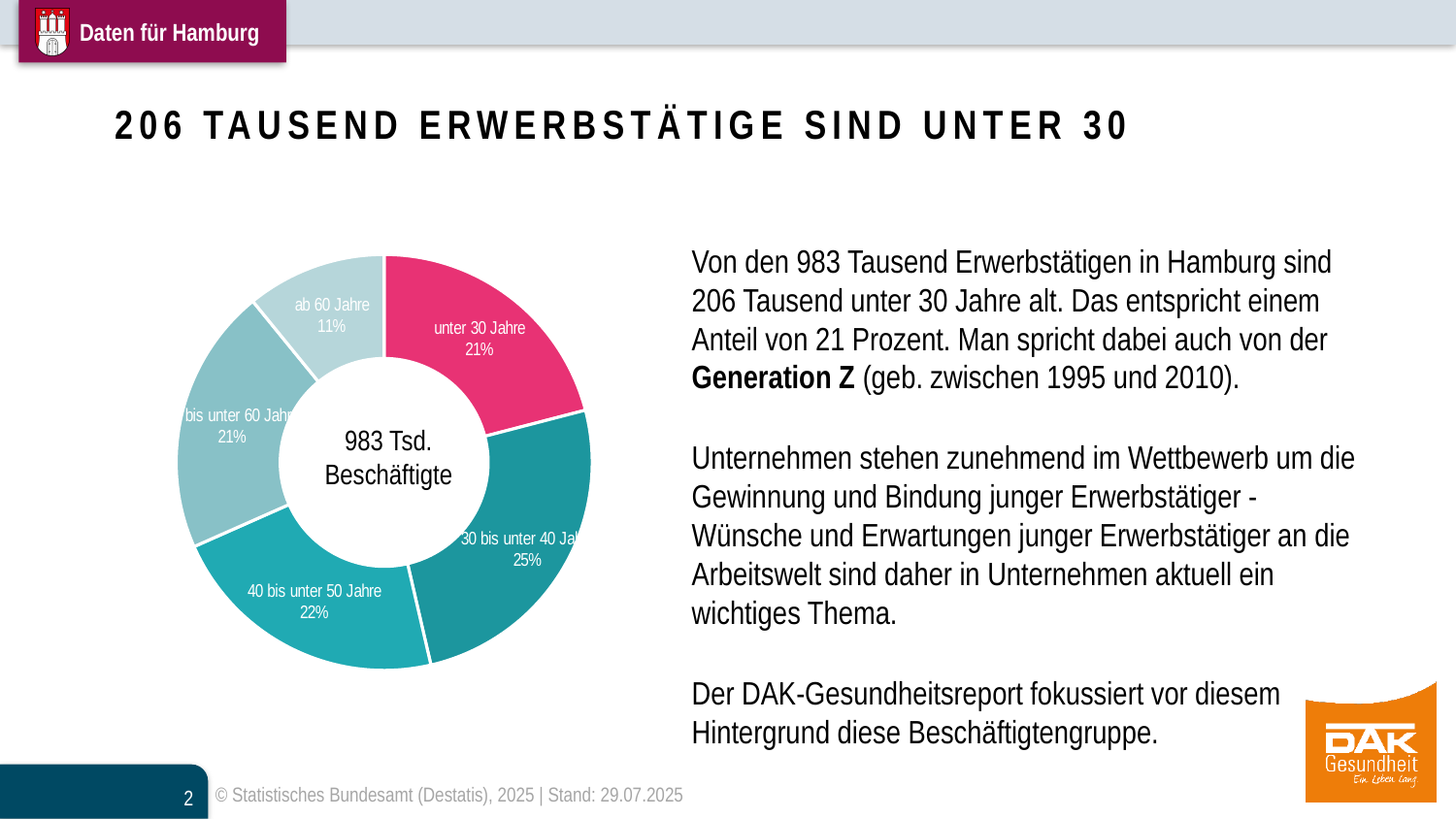
What is the difference in percentage points between the "30 bis unter 40 Jahre" slice and the "ab 60 Jahre" slice? 14 percentage points What text is shown in the centre of the doughnut chart? 983 Tsd. Beschäftigte Which age group has the smallest share in the chart? ab 60 Jahre Which age group has the largest share in the chart? 30 bis unter 40 Jahre What is the value shown for "ab 60 Jahre"? 11% Which slice is larger: "40 bis unter 50 Jahre" or "unter 30 Jahre"? 40 bis unter 50 Jahre What share of the doughnut chart does the slice "unter 30 Jahre" represent? 21% What kind of chart is shown on the slide? doughnut chart What is the difference in percentage points between the "40 bis unter 50 Jahre" slice and the "unter 30 Jahre" slice? 1 percentage point How many slices does the doughnut chart have? 5 What is the value shown for "30 bis unter 40 Jahre"? 25% What is the value shown for "40 bis unter 50 Jahre"? 22%